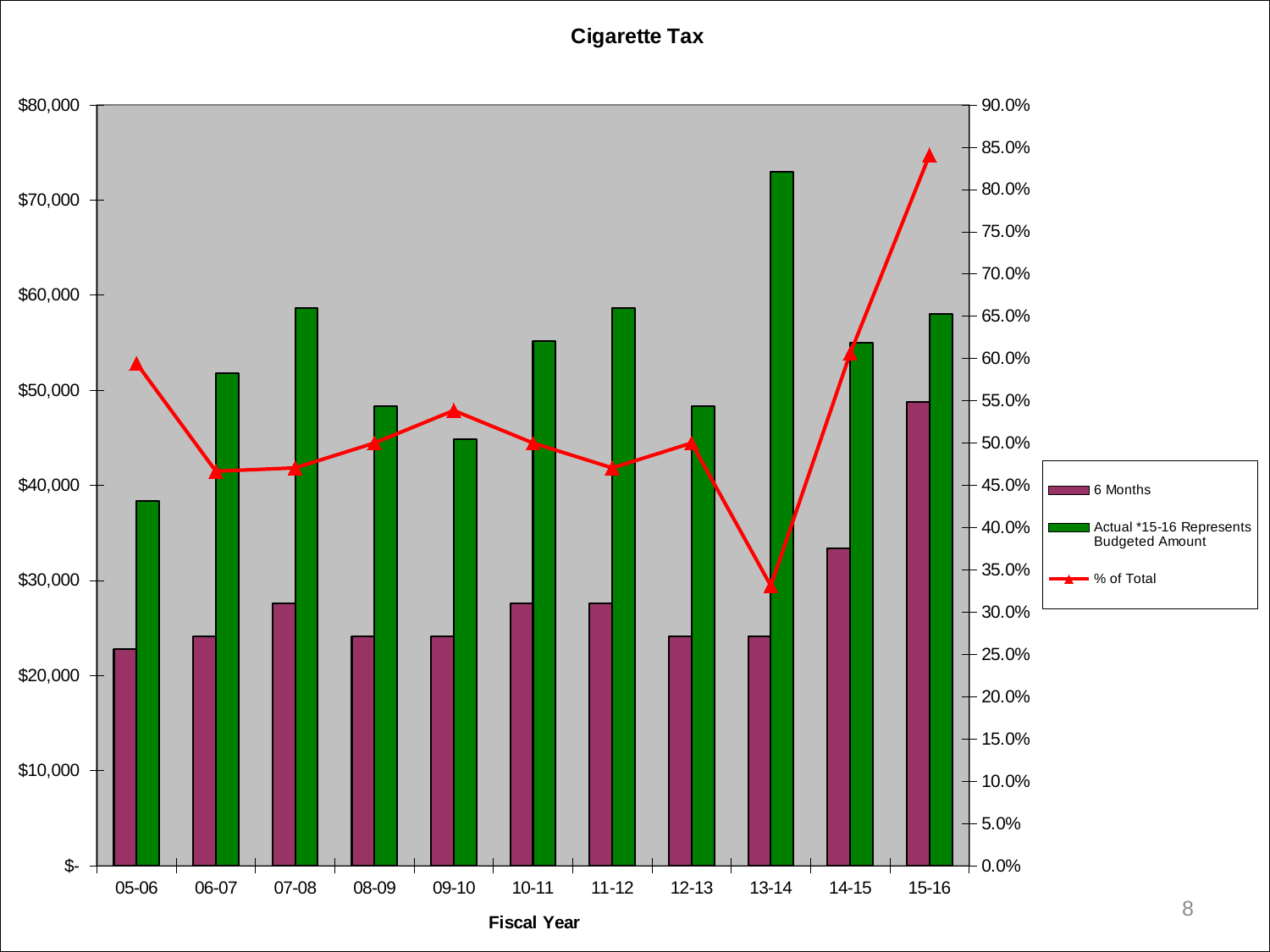
Which fiscal year has the lowest Actual bar? 05-06 How many fiscal years are shown on the x axis? 11 Which fiscal year has the lowest % of Total value? 13-14 Is the Actual value for 13-14 greater or less than $70,000? greater What is the label of the x axis? Fiscal Year What is the title of the chart? Cigarette Tax What kind of chart is shown on the slide? A combined bar and line chart Which fiscal year has the highest 6 Months bar? 15-16 Is the % of Total value for 13-14 greater or less than 35.0%? less How many series does the legend list? 3 Which fiscal year has the highest Actual bar? 13-14 Which fiscal year has the highest % of Total value? 15-16